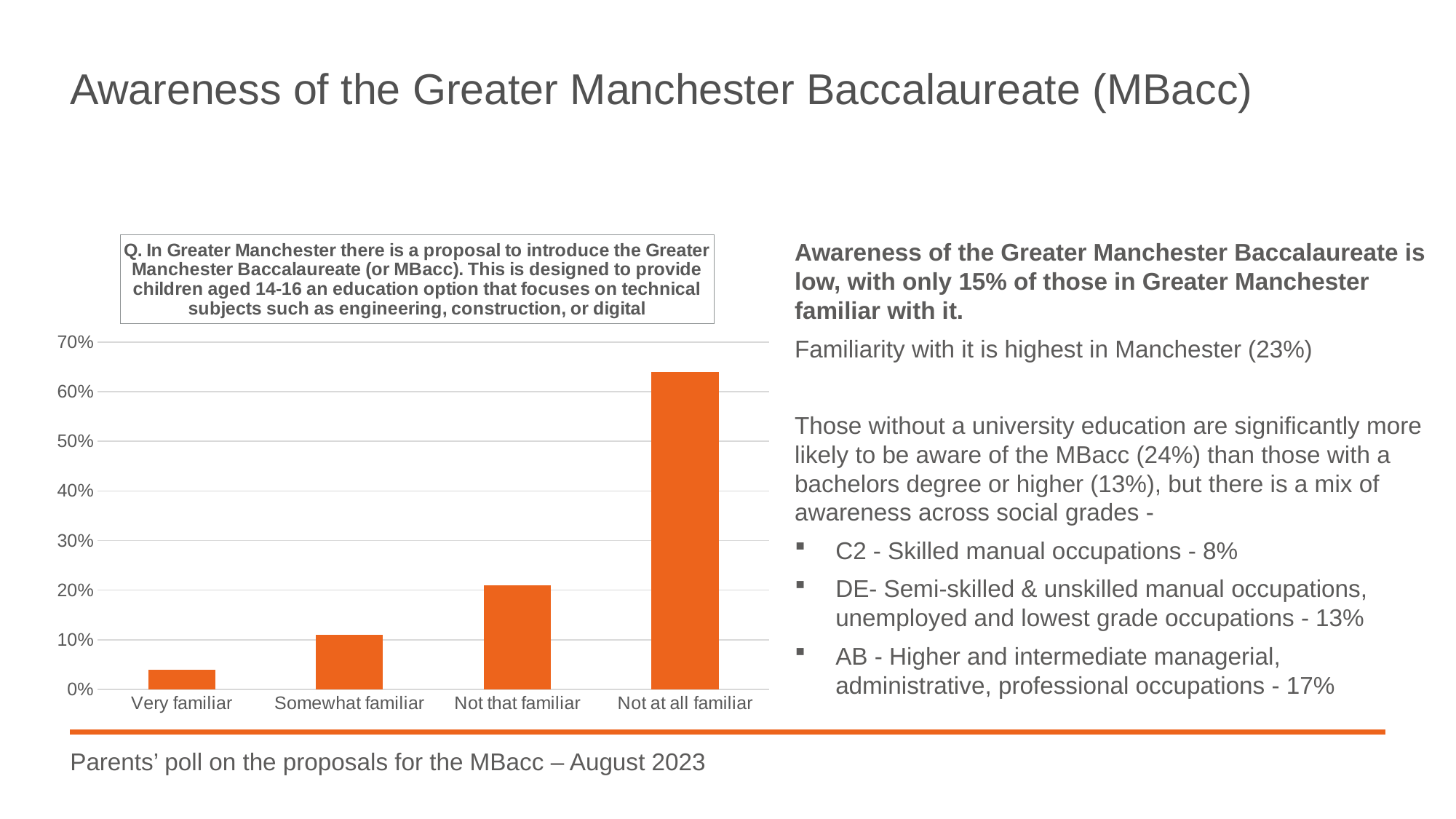
What colour are the bars in the chart? orange Which category has the highest value in the chart? Not at all familiar Is the value for Very familiar greater or less than 10%? less What kind of chart is shown on the slide? bar chart Do the values rise or fall moving from Very familiar to Not at all familiar along the x axis? rise How many categories are shown on the x axis of the chart? 4 Is the value for Not that familiar greater or less than 30%? less Which category has the lowest value in the chart? Very familiar Which is larger, the value for Not that familiar or the value for Somewhat familiar? Not that familiar Is the value for Somewhat familiar greater or less than 20%? less